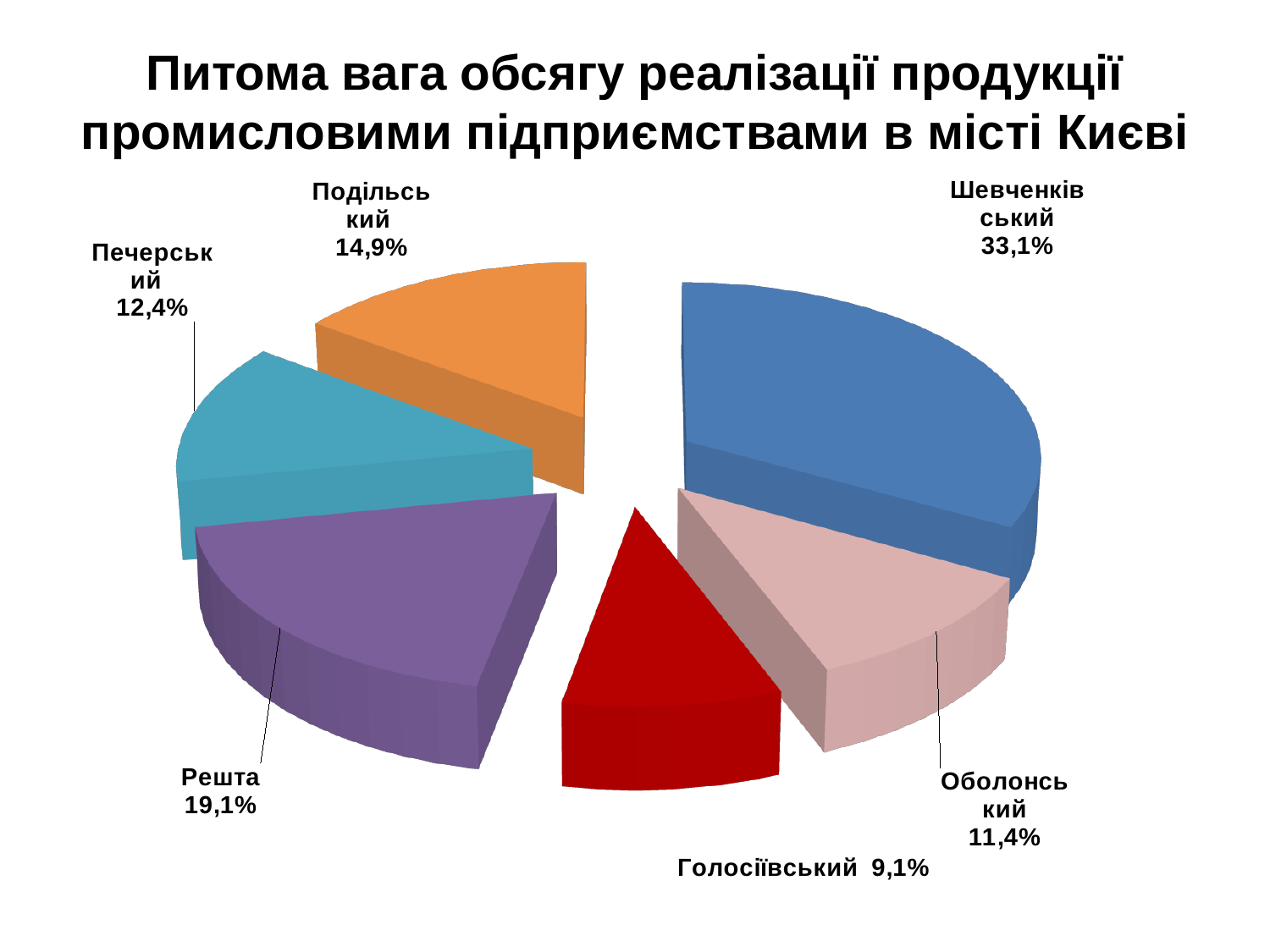
Which category has the smallest slice of the pie? Голосіївський What is the value shown for Голосіївський? 9,1% What kind of chart is shown on the slide? Pie chart What is the value shown for Решта? 19,1% What is the value shown for Печерський? 12,4% What is the difference between the values for Шевченківський and Решта? 14,0% What is the value shown for Оболонський? 11,4% Which is larger, the value for Подільський or the value for Печерський? Подільський How many categories are shown in the pie chart? 6 What share of the pie does Шевченківський have? 33,1% What is the difference between the values for Подільський and Печерський? 2,5% Which category has the largest slice of the pie? Шевченківський